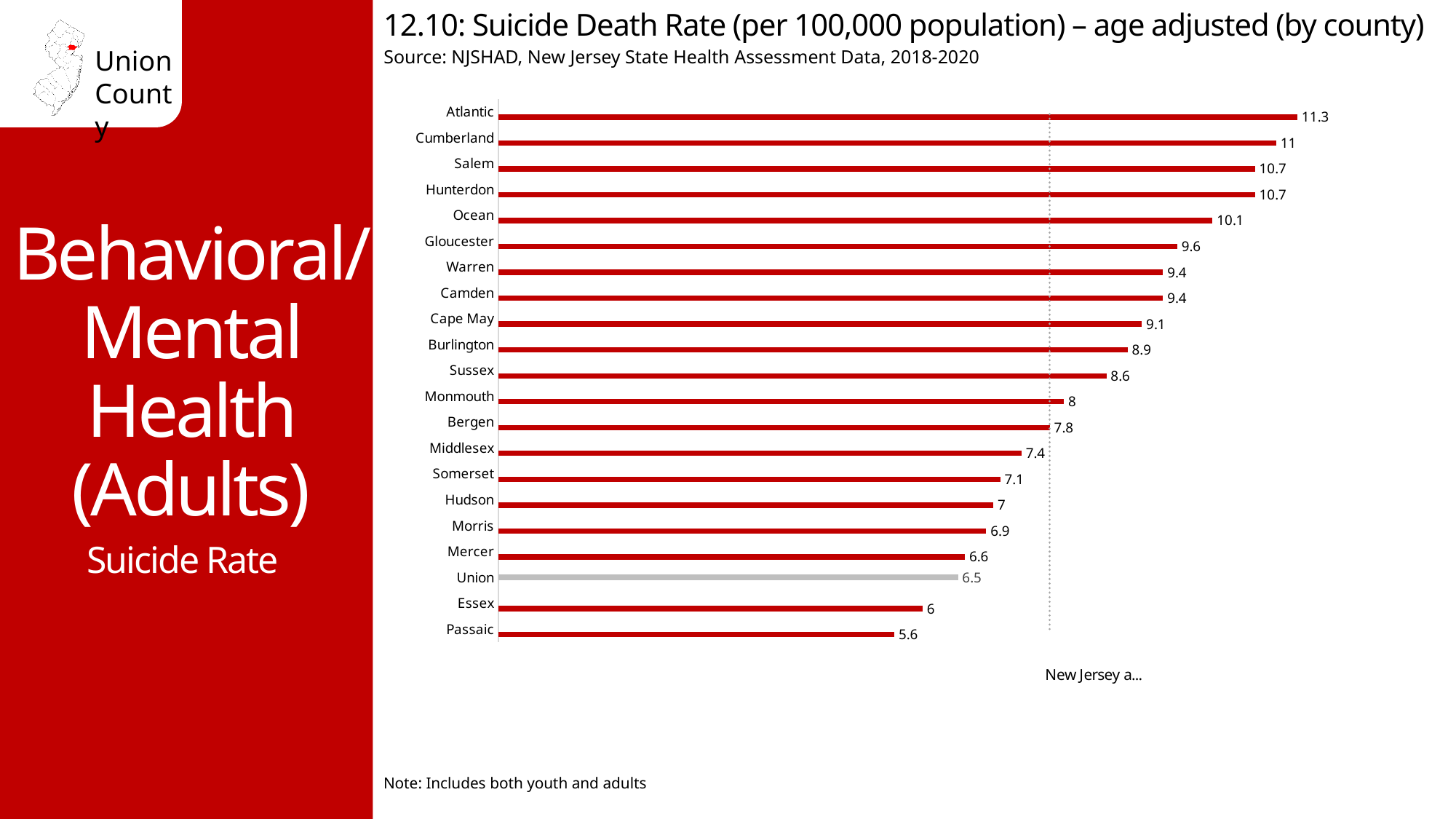
What is the suicide death rate for Monmouth County? 8 Which county has the highest suicide death rate? Atlantic Which county has the lowest suicide death rate? Passaic How many counties are shown in the chart? 21 Which county has a higher suicide death rate, Essex or Mercer? Mercer Which county has a higher suicide death rate, Gloucester or Bergen? Gloucester What is the suicide death rate for Union County? 6.5 Which county's bar is coloured grey instead of red? Union What is the difference between the suicide death rates of Ocean and Union counties? 3.6 What is the suicide death rate for Atlantic County? 11.3 What is the difference between the suicide death rates of Atlantic and Passaic counties? 5.7 What type of chart is shown on the slide? Bar chart